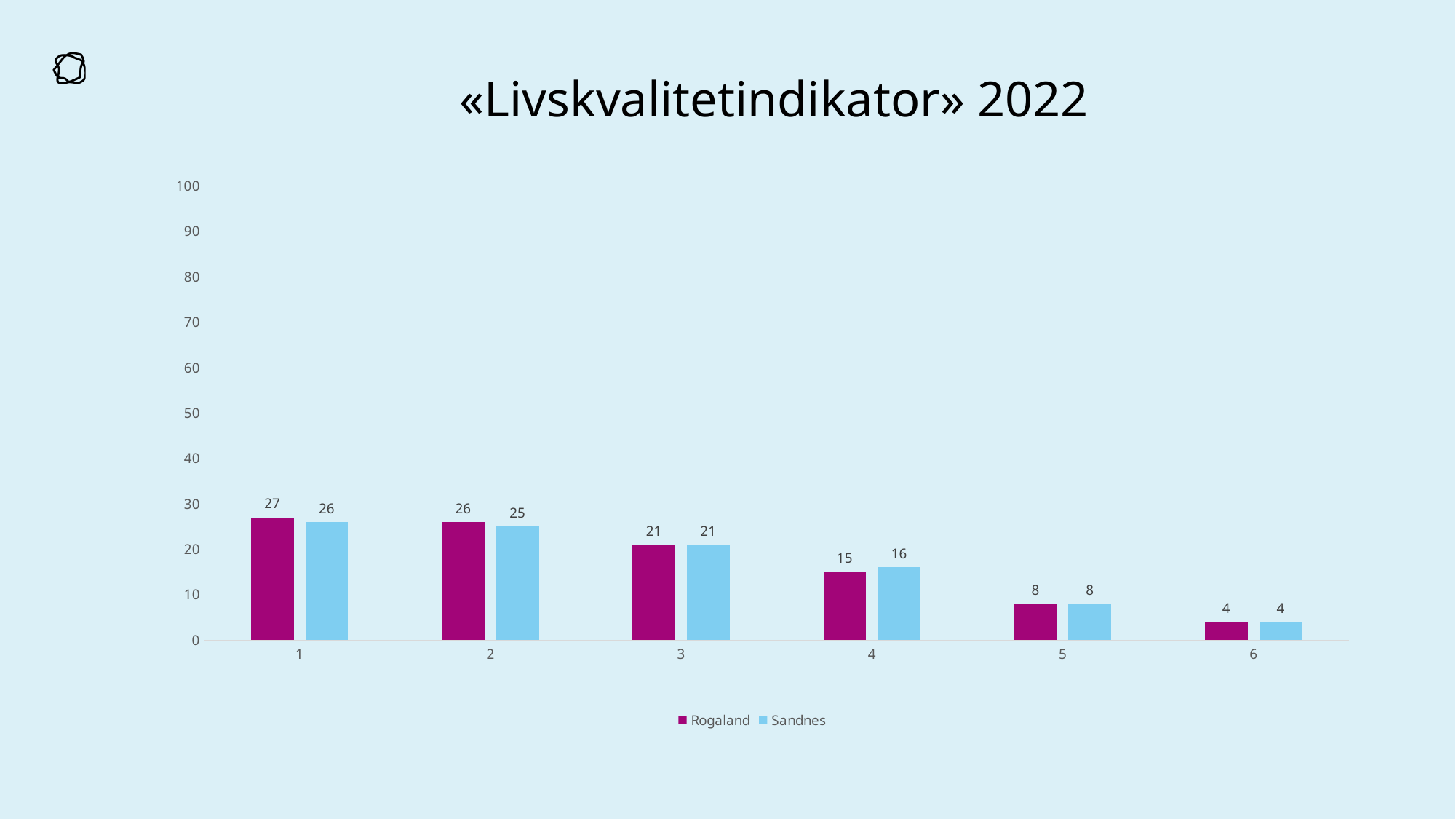
Which category has the lowest value for Sandnes? 6 What is the value for Sandnes at category 4? 16 How many series does the legend list? 2 What is the difference between the Rogaland values at category 2 and category 5? 18 What kind of chart is shown on the slide? Bar chart What is the value for Sandnes at category 2? 25 What is the difference between the Rogaland and Sandnes values at category 1? 1 How many categories are shown on the x axis? 6 What is the value for Rogaland at category 1? 27 Which category has the highest value for Rogaland? 1 Which is larger at category 4: the Rogaland value or the Sandnes value? Sandnes Do the Sandnes values rise or fall from category 1 to category 6? Fall